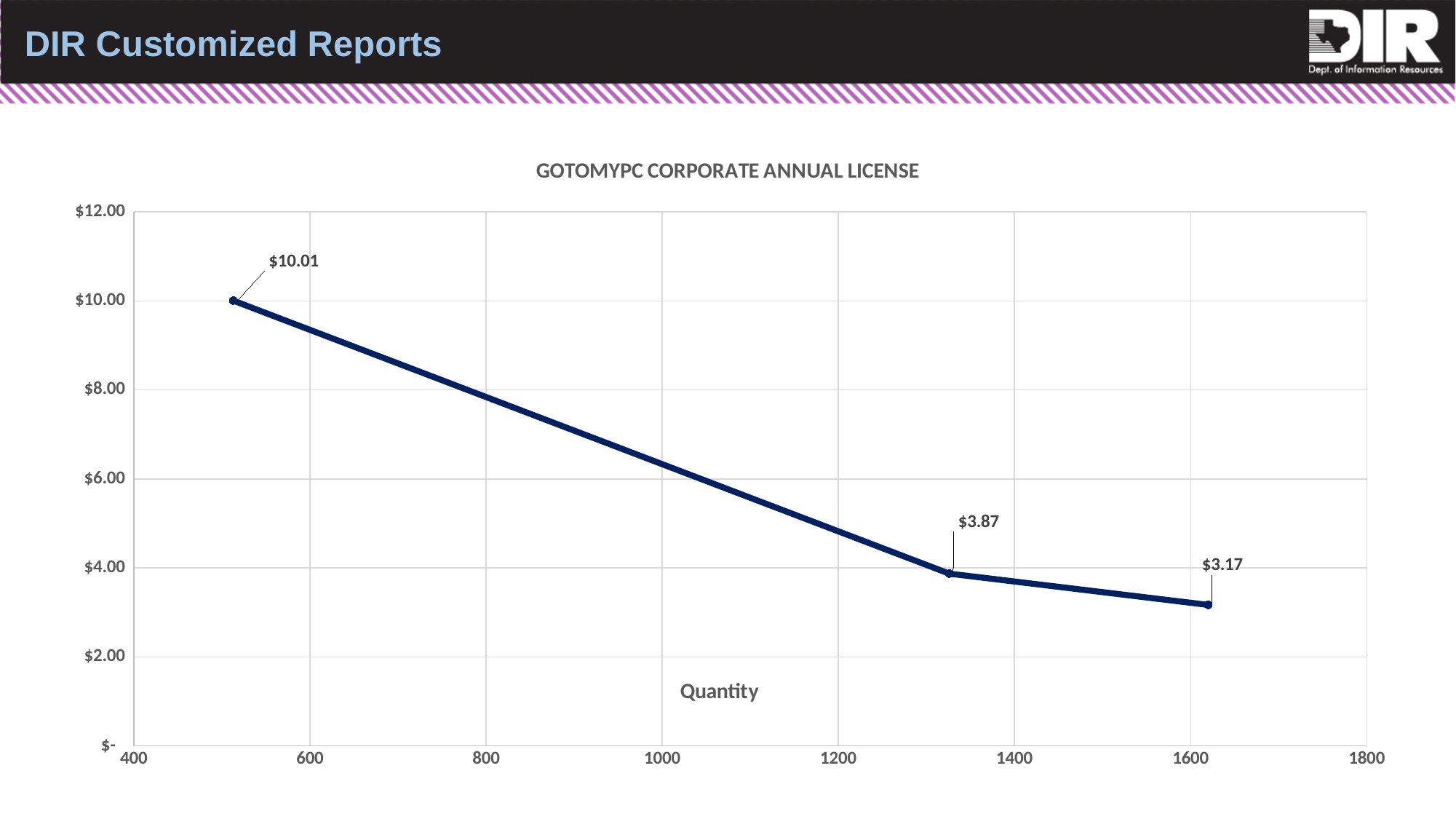
What is the highest value plotted on the chart? $10.01 What is the title of the chart? GOTOMYPC CORPORATE ANNUAL LICENSE What kind of chart is shown on the slide? line chart What is the lowest value plotted on the chart? $3.17 Is the value of the middle data point greater or less than $4.00? less What is the label on the x axis of the chart? Quantity How many data points are plotted on the line? 3 What is the value of the rightmost data point on the line? $3.17 Do the values rise or fall as quantity increases along the x axis? fall What is the value of the leftmost data point on the line? $10.01 What is the value of the middle data point on the line? $3.87 What is the difference between the leftmost data point and the rightmost data point? $6.84